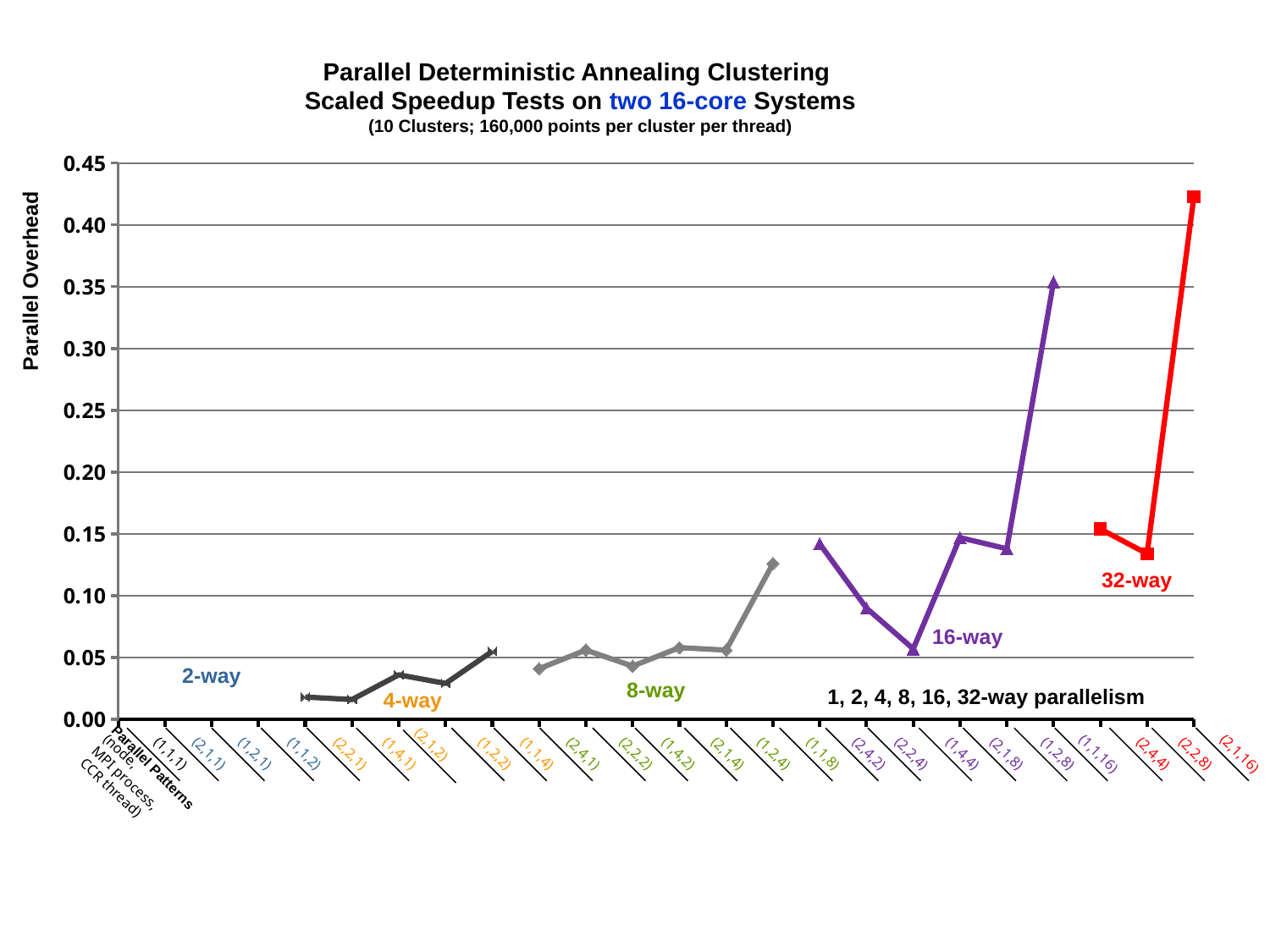
Which parallel pattern has the highest parallel overhead on the chart? (2,2,8) Which has the larger parallel overhead, (1,2,4) or (1,1,4)? (1,2,4) Is the parallel overhead for (2,2,4) greater or less than 0.10? less Is the parallel overhead for (2,2,8) greater or less than 0.40? greater Is the parallel overhead for (1,2,8) greater or less than 0.30? greater What colour is the 32-way line? red Does the 8-way line rise or fall overall from (1,1,4) to (1,2,4)? rise What kind of chart is shown on the slide? line chart Which has the larger parallel overhead, (2,2,8) or (1,2,8)? (2,2,8) What is the label of the y axis? Parallel Overhead